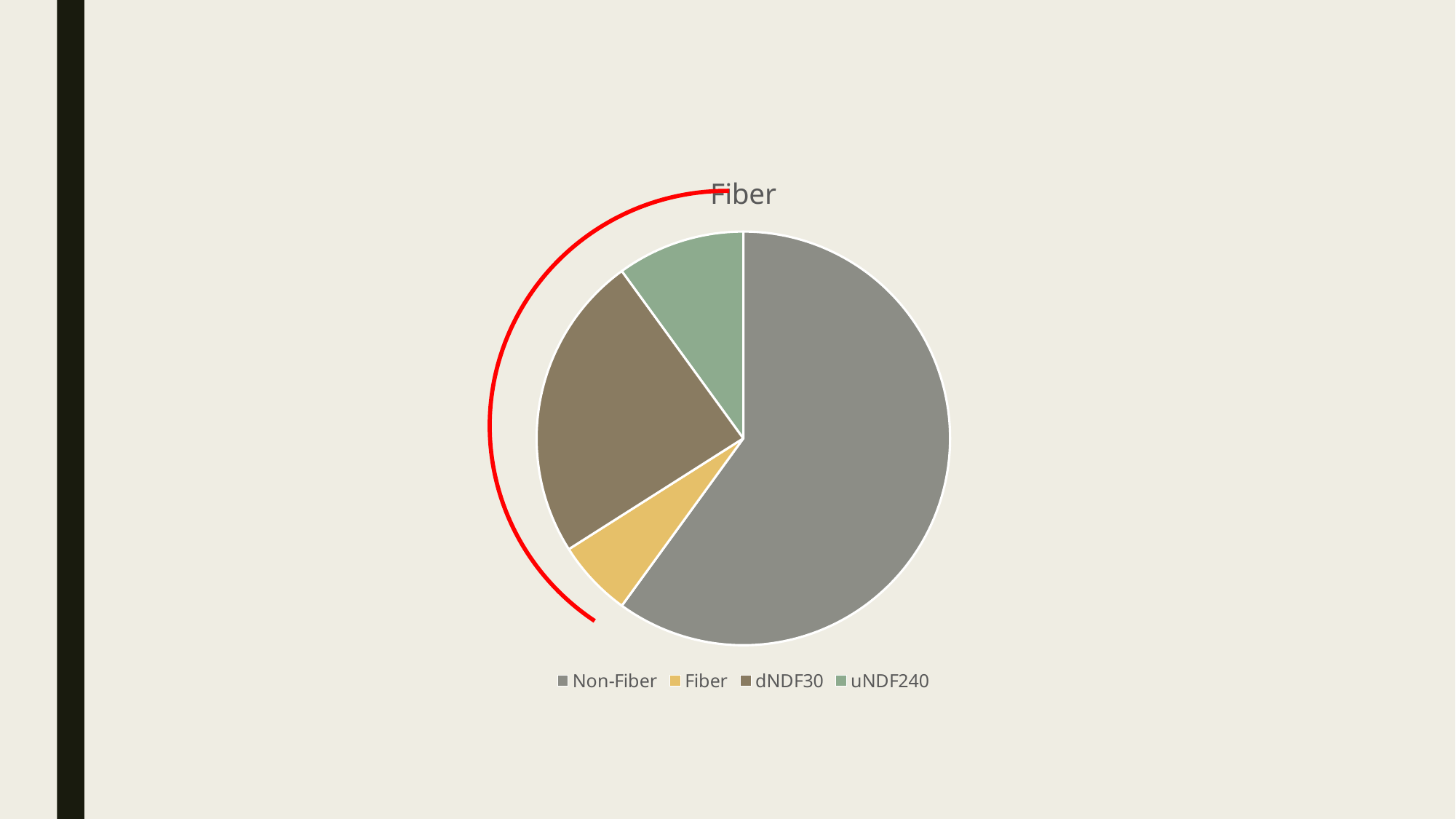
Which slice is larger, dNDF30 or uNDF240? dNDF30 Which slice is larger, Non-Fiber or dNDF30? Non-Fiber Which category has the smallest slice of the pie? Fiber What is the title of the chart? Fiber Which slice is larger, Non-Fiber or uNDF240? Non-Fiber Which legend entry is shown in yellow? Fiber Does the Non-Fiber slice take up more or less than half of the pie? more How many slices does the pie chart have? 4 How many entries does the legend list? 4 Which category has the largest slice of the pie? Non-Fiber What kind of chart is shown on the slide? pie chart